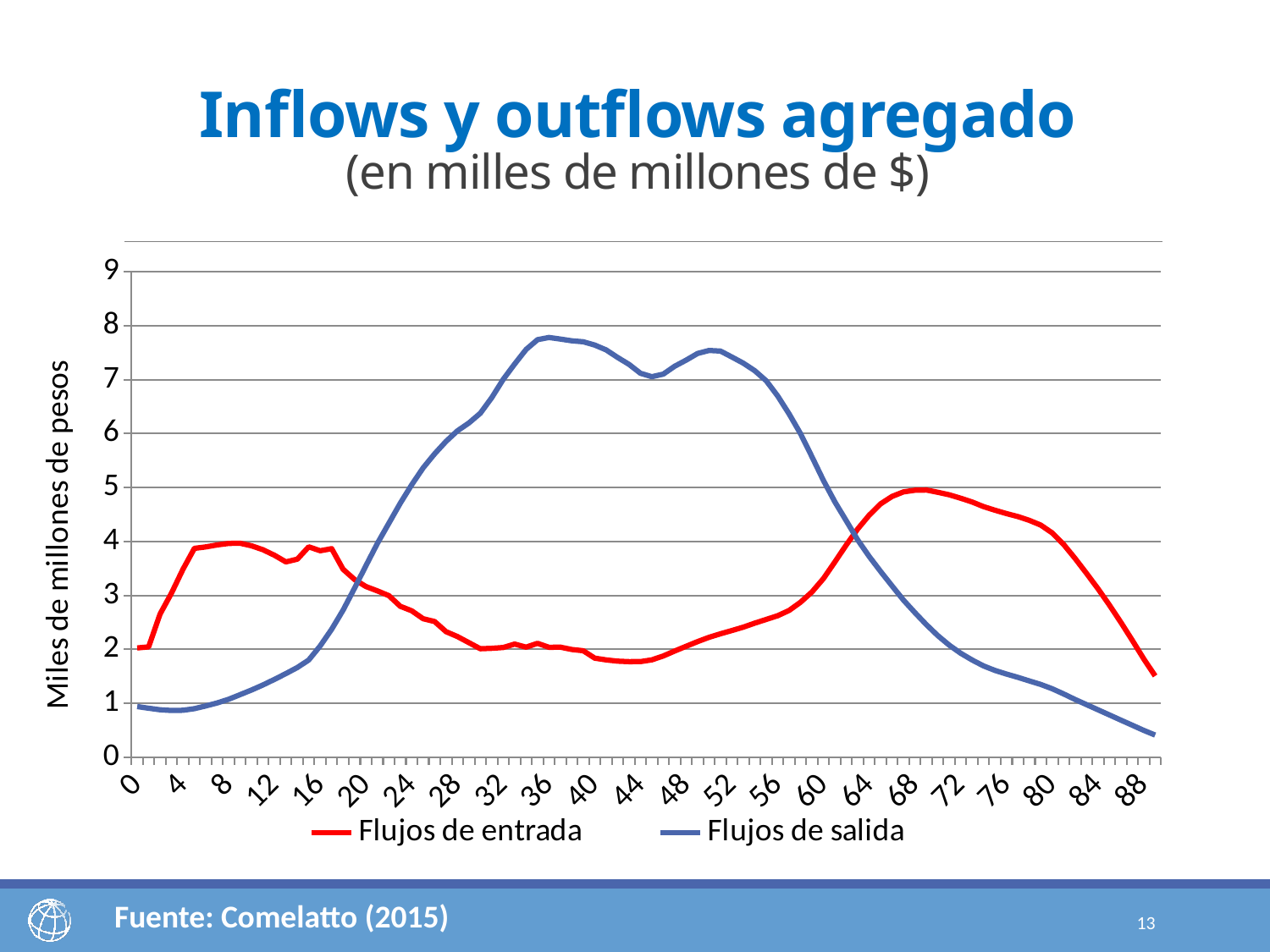
What kind of chart is shown on the slide? Line chart Is the value for Flujos de entrada at 44 greater or less than 2? less Is the value for Flujos de entrada at 68 greater or less than 4? greater At 36 on the x axis, which series has the larger value, Flujos de entrada or Flujos de salida? Flujos de salida Does Flujos de salida rise or fall between 0 and 36 on the x axis? Rise At 80 on the x axis, which series has the larger value, Flujos de entrada or Flujos de salida? Flujos de entrada Is the value for Flujos de salida at 36 greater or less than 7? greater Which series reaches the highest value on the chart? Flujos de salida How many series does the legend list? 2 Does Flujos de entrada rise or fall between 68 and 88 on the x axis? Fall What is the label of the y axis? Miles de millones de pesos